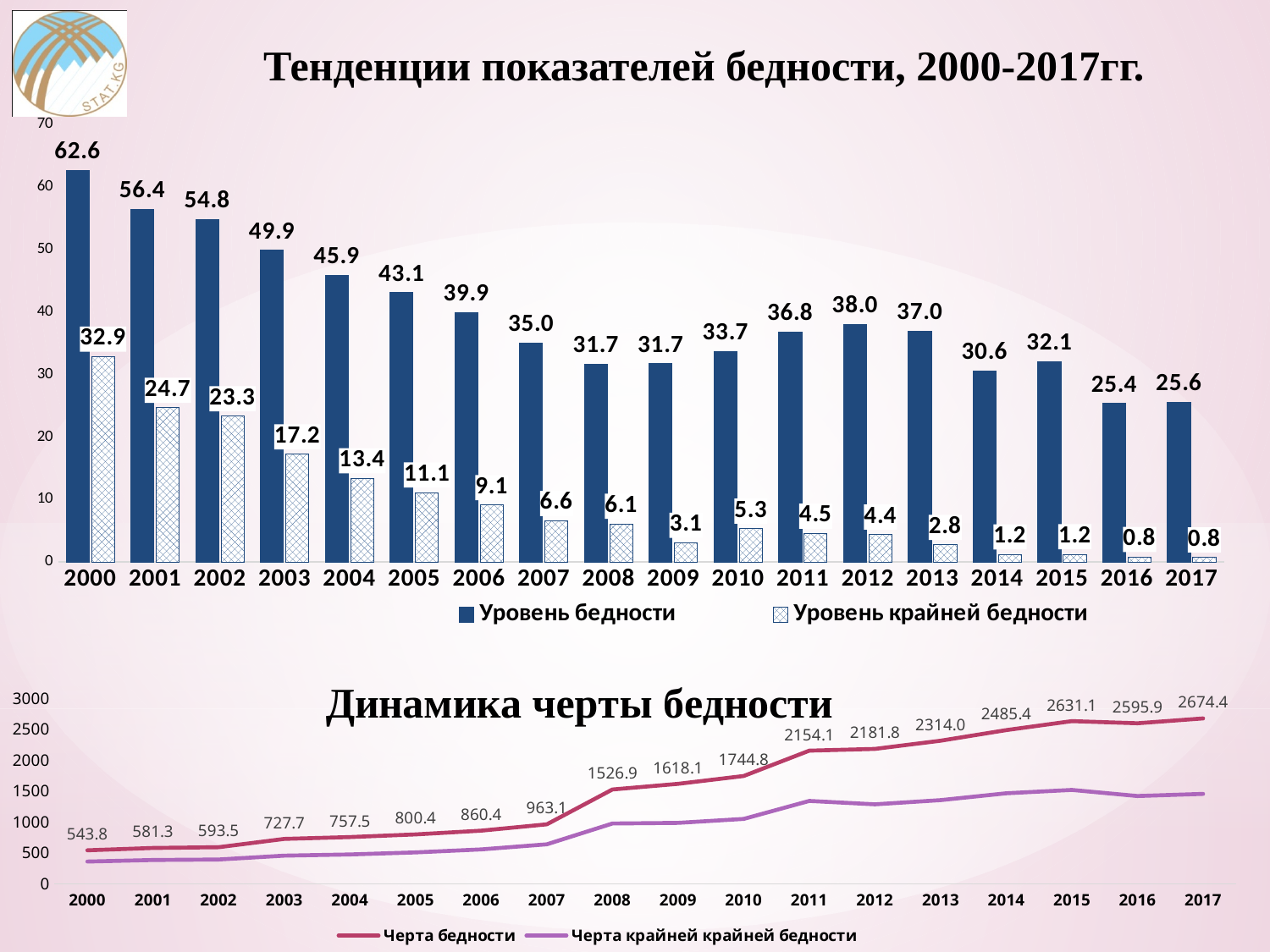
In the top bar chart, which year has the lowest 'Уровень бедности'? 2016 In the top bar chart 'Тенденции показателей бедности, 2000-2017гг.', what is the value of 'Уровень бедности' for 2000? 62.6 In the top bar chart, what is the value of 'Уровень крайней бедности' for 2003? 17.2 In the bottom chart 'Динамика черты бедности', what is the value of 'Черта бедности' for 2017? 2674.4 In the bottom chart, is the value of 'Черта крайней крайней бедности' for 2017 greater or less than 2000? less In the top bar chart, which year has the larger 'Уровень бедности', 2012 or 2013? 2012 In the top bar chart, what is the difference between 'Уровень бедности' and 'Уровень крайней бедности' in 2000? 29.7 What kind of chart is the bottom chart 'Динамика черты бедности'? Line chart How many series does the legend of the top chart list? 2 How many years are shown on the x axis of the top bar chart? 18 In the top bar chart, which year has the highest 'Уровень бедности'? 2000 In the bottom chart, does 'Черта бедности' generally rise or fall from 2000 to 2017? Rise